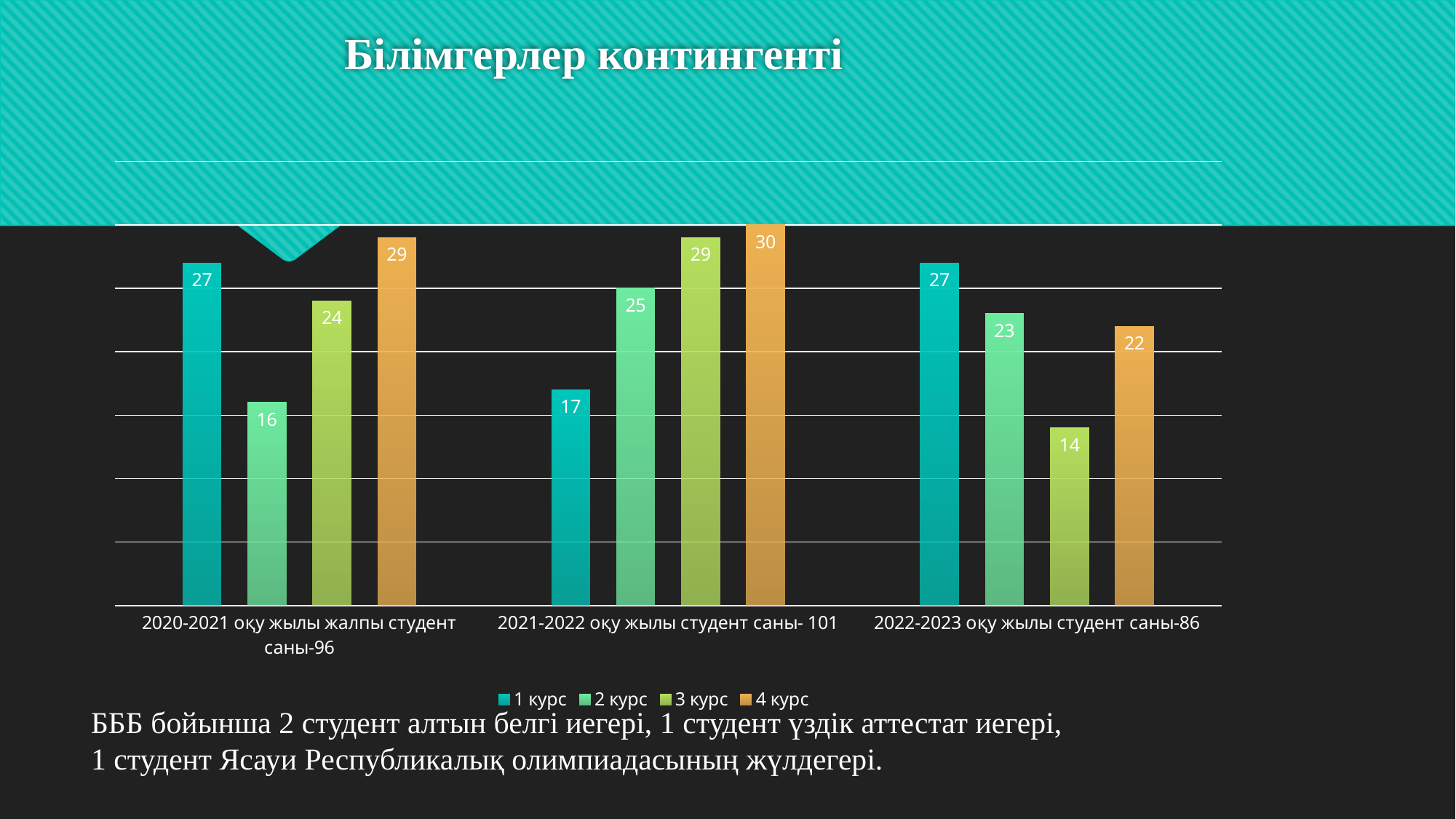
Which series has the lowest value in the 2022-2023 оқу жылы category? 3 курс What is the title of the slide above the chart? Білімгерлер контингенті How many categories are shown on the x axis? 3 What is the value for 2 курс in the 2020-2021 оқу жылы category? 16 Which series has the highest value in the 2021-2022 оқу жылы category? 4 курс What kind of chart is shown on the slide? bar chart What is the difference between the 4 курс and 2 курс values in the 2020-2021 оқу жылы category? 13 What is the value for 1 курс in the 2020-2021 оқу жылы category? 27 Which is larger: the 2 курс value in 2021-2022 or the 2 курс value in 2022-2023? 2021-2022 What is the value for 3 курс in the 2021-2022 оқу жылы category? 29 How many series does the legend list? 4 What is the value for 4 курс in the 2022-2023 оқу жылы category? 22